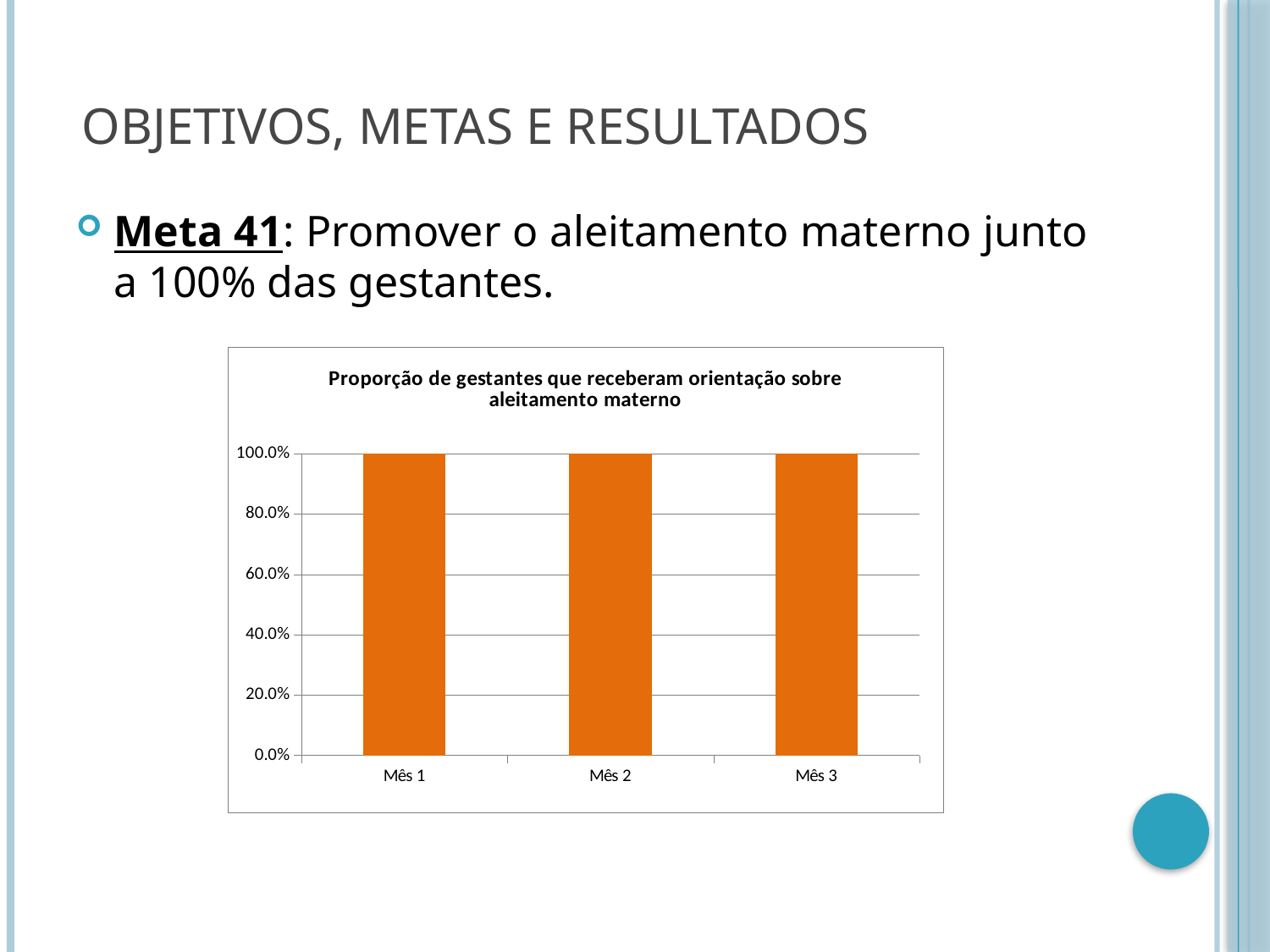
Do the values rise, fall or stay the same from Mês 1 to Mês 3? stay the same What kind of chart is shown on the slide? bar chart Is the value for Mês 2 greater or less than 80.0%? greater What colour are the bars in the chart? orange What is the title of the chart? Proporção de gestantes que receberam orientação sobre aleitamento materno What is the value for Mês 2? 100.0% What is the difference between the values for Mês 1 and Mês 3? 0.0% What is the value for Mês 1? 100.0% Is the value for Mês 3 greater or less than 60.0%? greater How many categories are shown on the x axis? 3 What is the highest value shown on the y axis? 100.0% What is the value for Mês 3? 100.0%